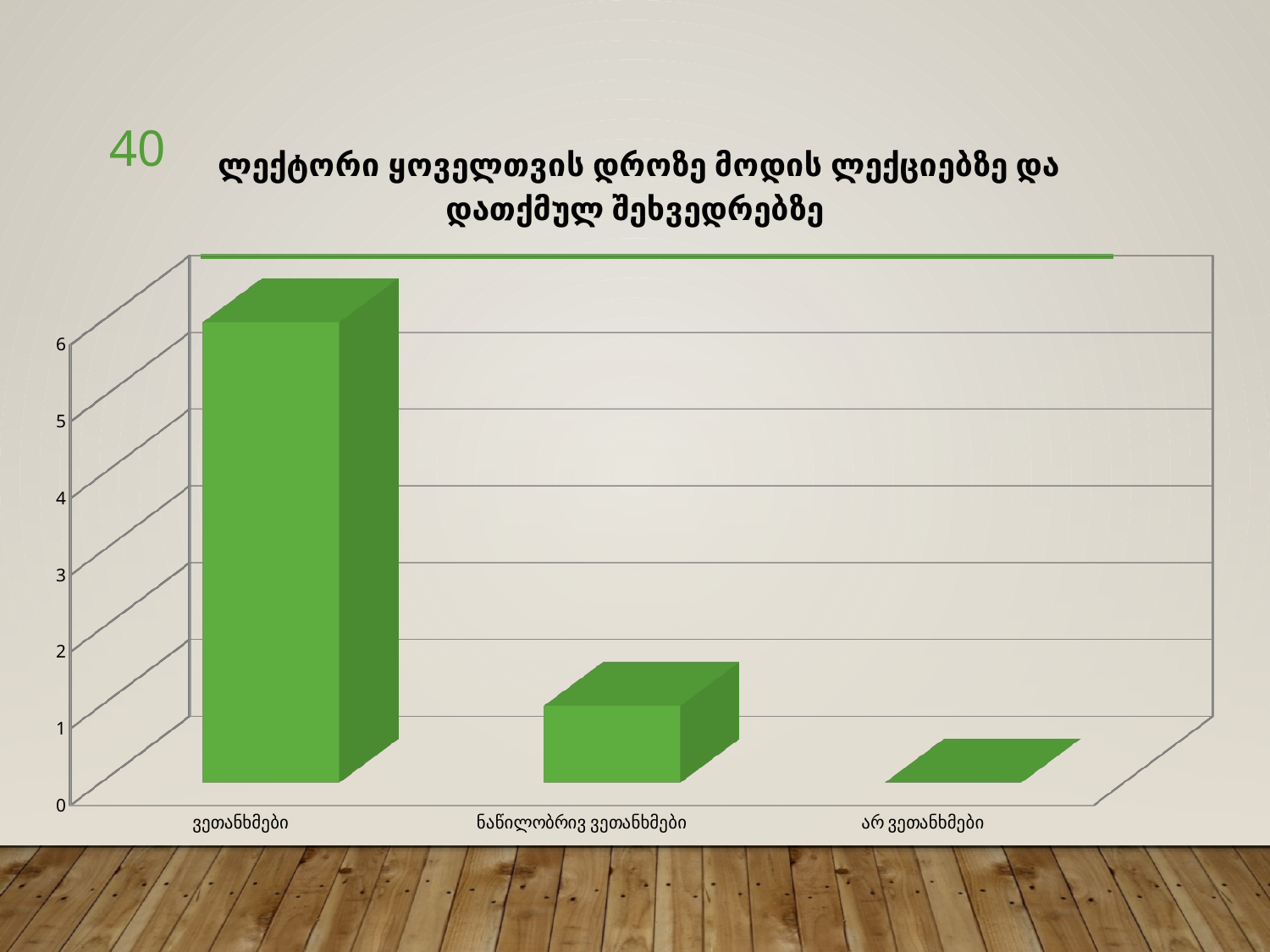
How many categories are shown on the x axis of the chart? 3 Which category has the lowest bar in the chart? არ ვეთანხმები Which category has the highest bar in the chart? ვეთანხმები What is the title of the chart? ლექტორი ყოველთვის დროზე მოდის ლექციებზე და დათქმულ შეხვედრებზე What kind of chart is shown on the slide? bar chart Do the bar values rise or fall from left to right along the x axis? fall Which is larger, the value for ვეთანხმები or the value for ნაწილობრივ ვეთანხმები? ვეთანხმები Is the value for არ ვეთანხმები greater or less than 1? less Which is larger, the value for ნაწილობრივ ვეთანხმები or the value for არ ვეთანხმები? ნაწილობრივ ვეთანხმები Is the value for ვეთანხმები greater or less than 4? greater What colour are the bars in the chart? green Is the value for ნაწილობრივ ვეთანხმები greater or less than 3? less